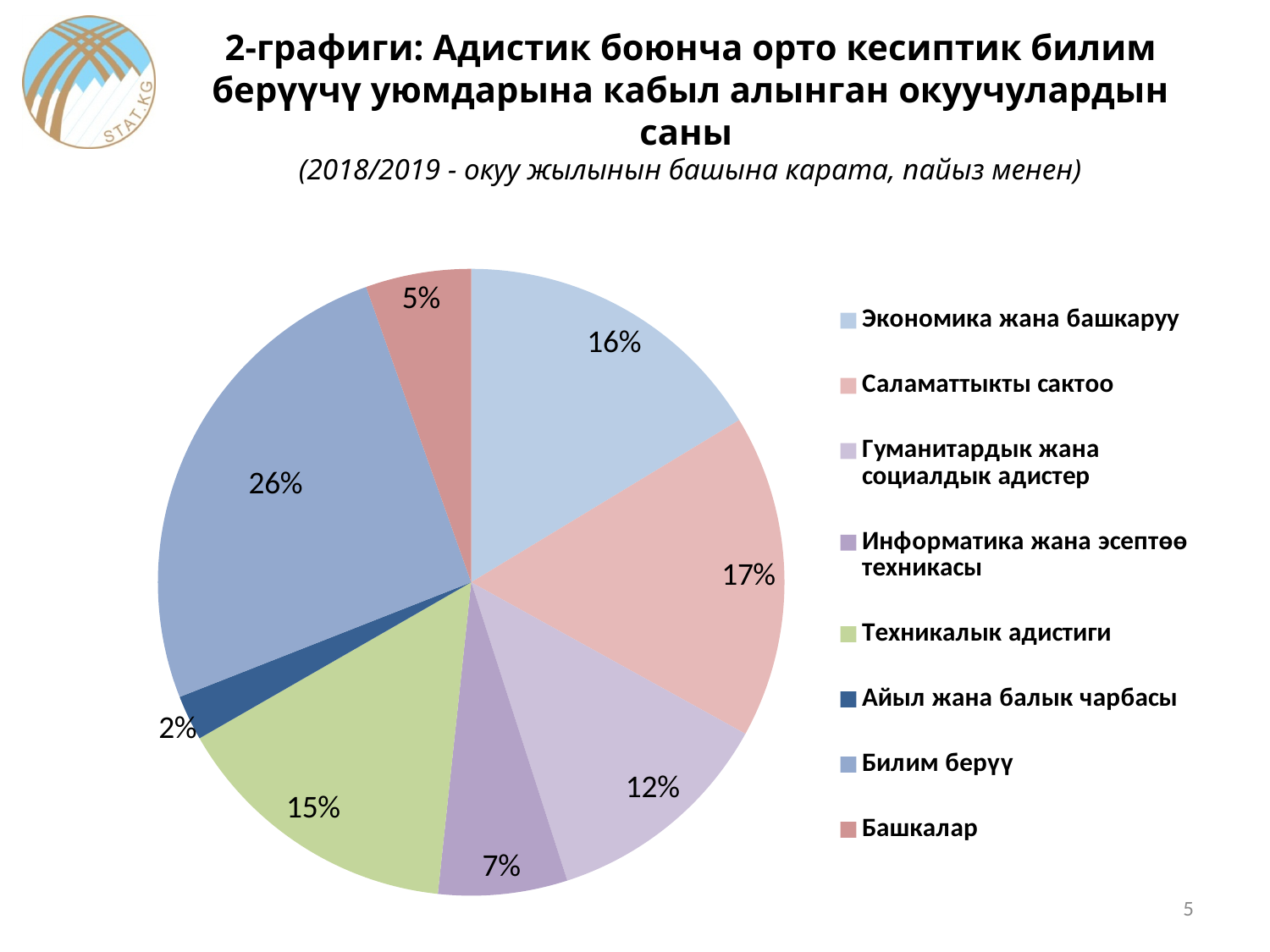
What is the value shown for Экономика жана башкаруу? 16% How many categories are shown in the pie chart? 8 Which academic year does the chart subtitle refer to? 2018/2019 What kind of chart is shown on the slide? Pie chart Which category has the smallest share of the pie? Айыл жана балык чарбасы What share of the pie does Билим берүү hold? 26% Which category has the largest share of the pie? Билим берүү What is the value shown for Информатика жана эсептөө техникасы? 7% Which is larger, the share for Гуманитардык жана социалдык адистер or the share for Техникалык адистиги? Техникалык адистиги What is the value shown for Саламаттыкты сактоо? 17% What is the value shown for Техникалык адистиги? 15% What is the difference between the shares of Билим берүү and Башкалар? 21%